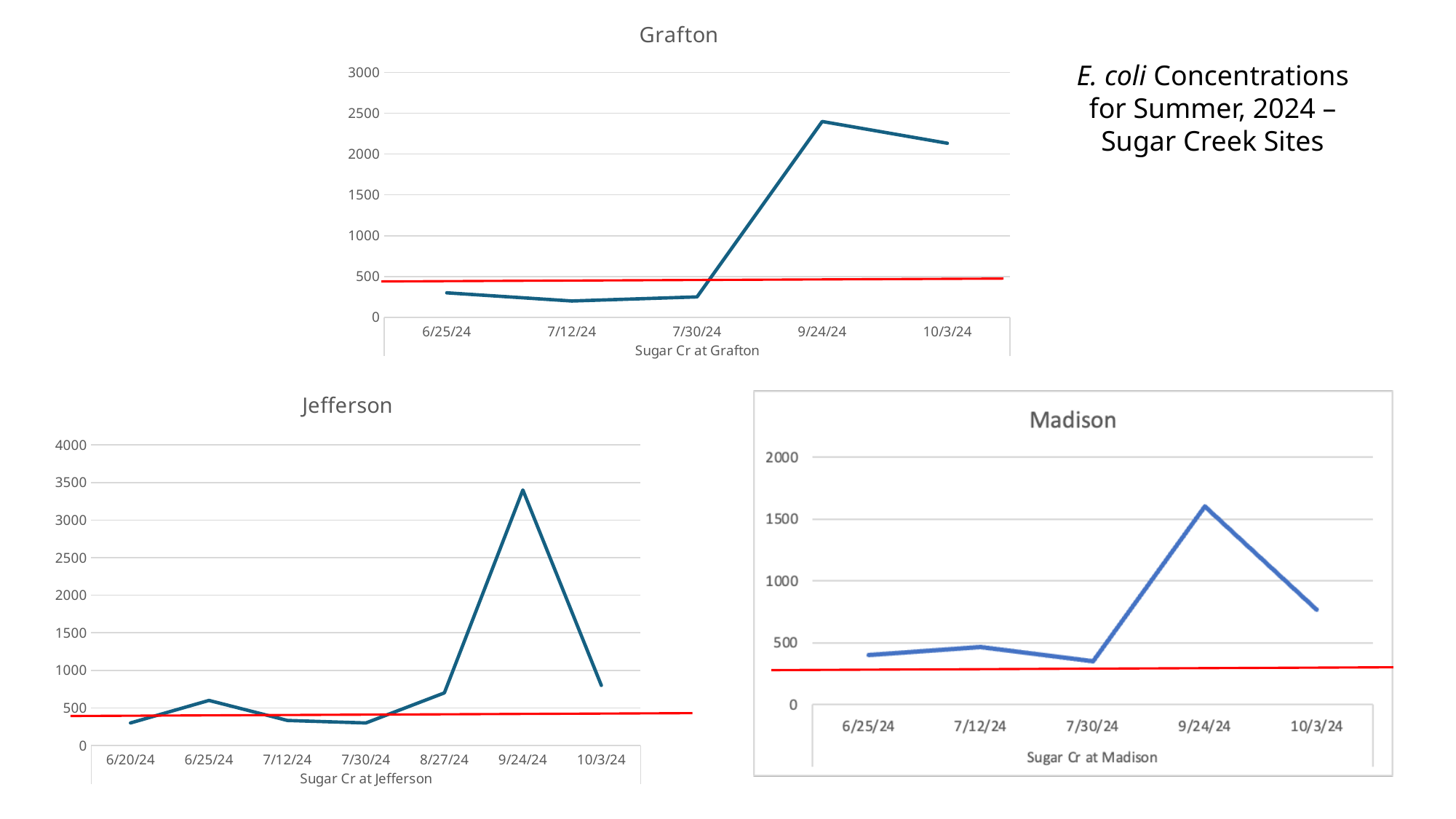
How many charts are on the slide? 3 What kind of chart is the Grafton chart? line chart In the Jefferson chart, how many dates are plotted on the x axis? 7 In the Grafton chart, on which date is the E. coli concentration highest? 9/24/24 In the Madison chart, on which date is the E. coli concentration highest? 9/24/24 In the Madison chart, is the value for 10/3/24 greater or less than 1000? less What is the x-axis title of the Madison chart? Sugar Cr at Madison In the Grafton chart, is the value for 9/24/24 greater or less than 2000? greater In the Madison chart, how many dates are plotted on the x axis? 5 In the Jefferson chart, on which date is the E. coli concentration highest? 9/24/24 In the Jefferson chart, is the value for 9/24/24 greater or less than 3000? greater In the Grafton chart, which is larger, the value for 9/24/24 or the value for 10/3/24? 9/24/24